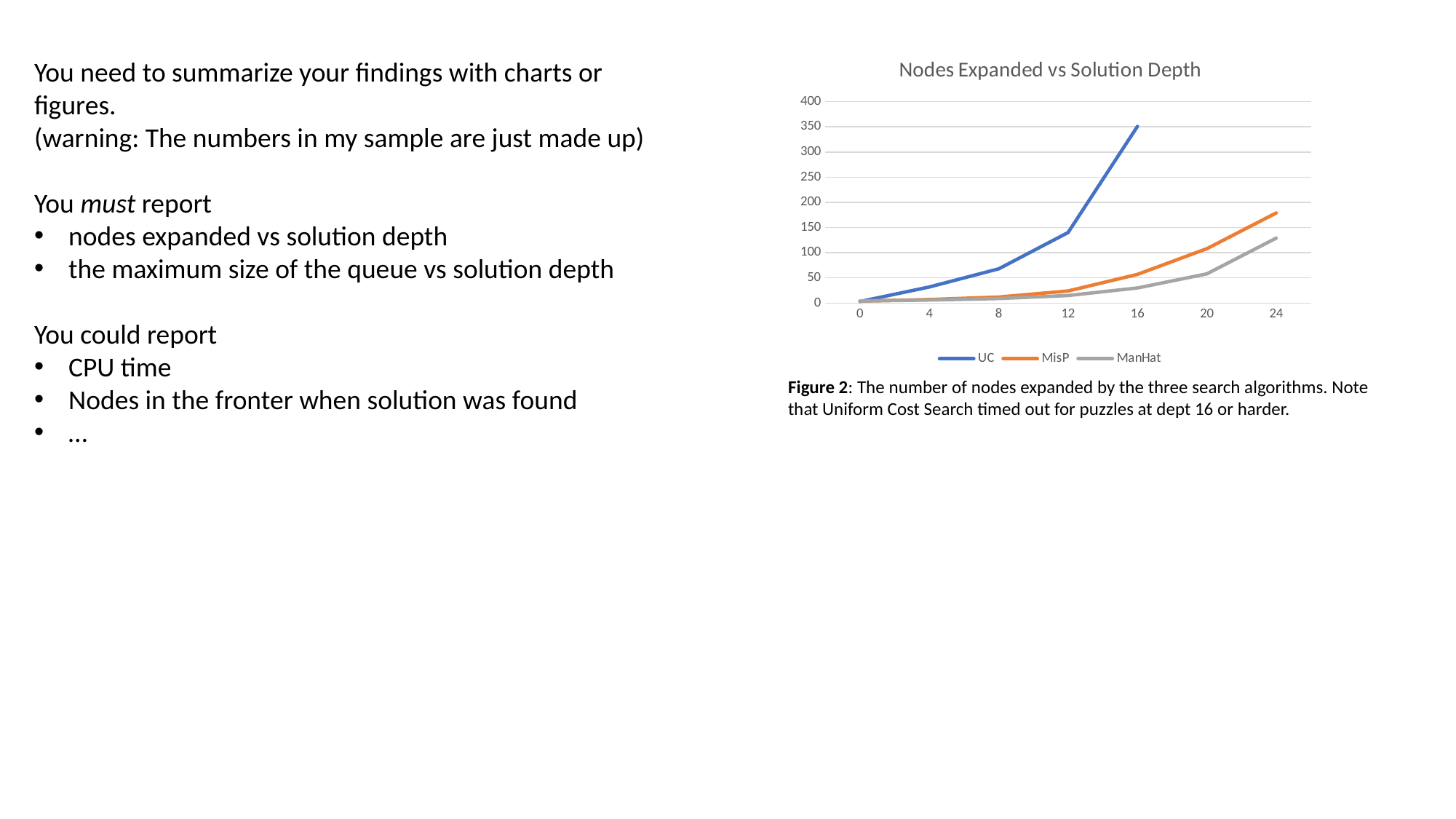
How many solution depth values are labelled on the x axis of the chart? 7 Is the value for MisP at solution depth 24 greater or less than 150? greater What is the title of the chart? Nodes Expanded vs Solution Depth What kind of chart is shown on the slide? line chart At solution depth 24, which series has the larger value, MisP or ManHat? MisP Which series has the highest value at solution depth 12? UC How many series does the legend of the chart list? 3 Is the value for ManHat at solution depth 24 greater or less than 150? less Is the value for UC at solution depth 12 greater or less than 100? greater What are the three series named in the chart's legend? UC, MisP, ManHat Do the values for the UC series rise or fall as solution depth increases? rise